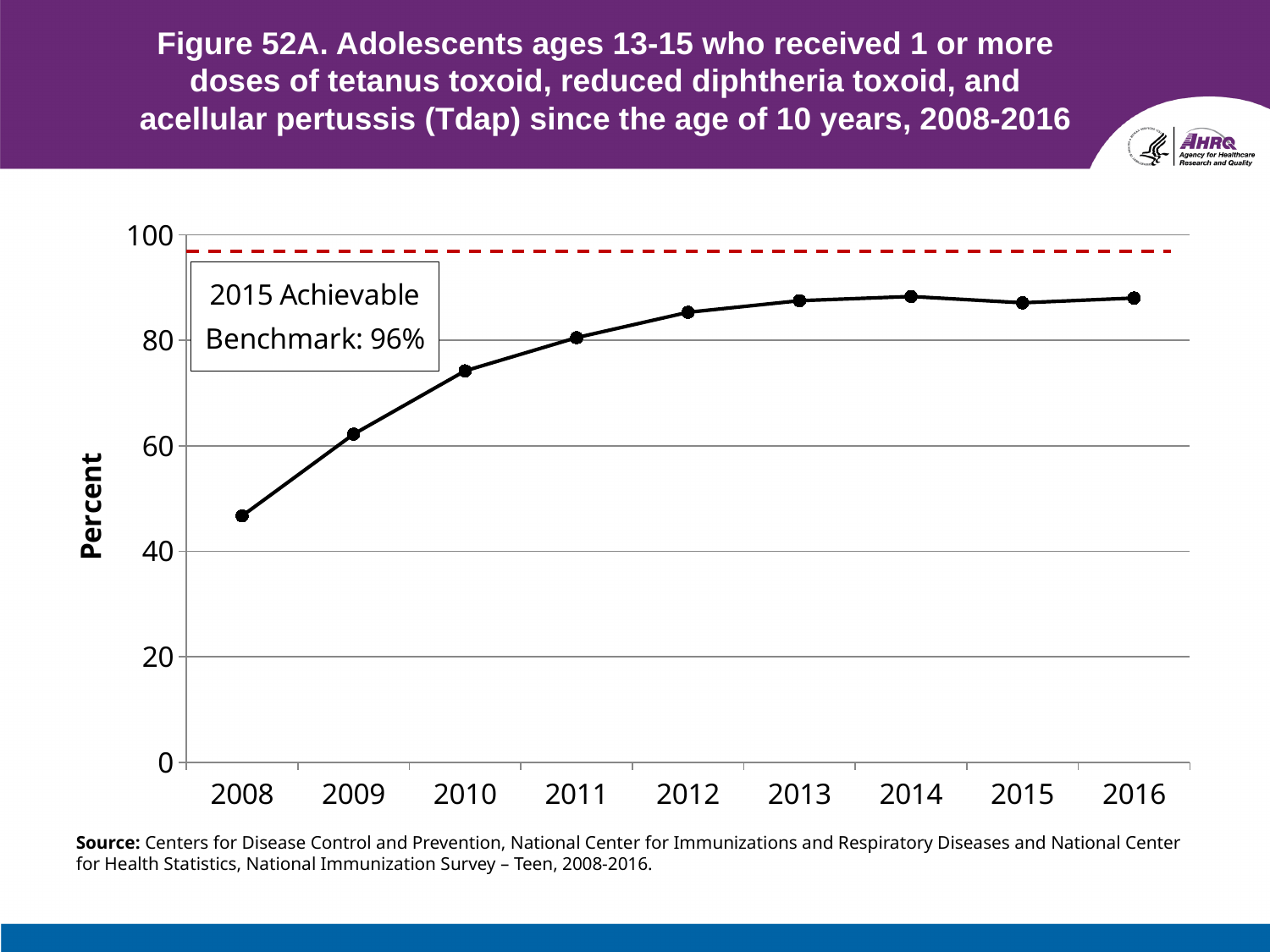
Is the value for 2012 greater or less than 80? greater Do the values generally rise or fall from 2008 to 2013? Rise What is the 2015 Achievable Benchmark shown on the chart? 96% What is the label on the y axis? Percent Which year has the larger value, 2008 or 2011? 2011 Which year has the lowest percentage of adolescents who received Tdap? 2008 How many years (data points) are plotted on the x axis? 9 What kind of chart is shown on the slide? Line chart Is the value for 2008 greater or less than 60? less Is the value for 2010 greater or less than 80? less